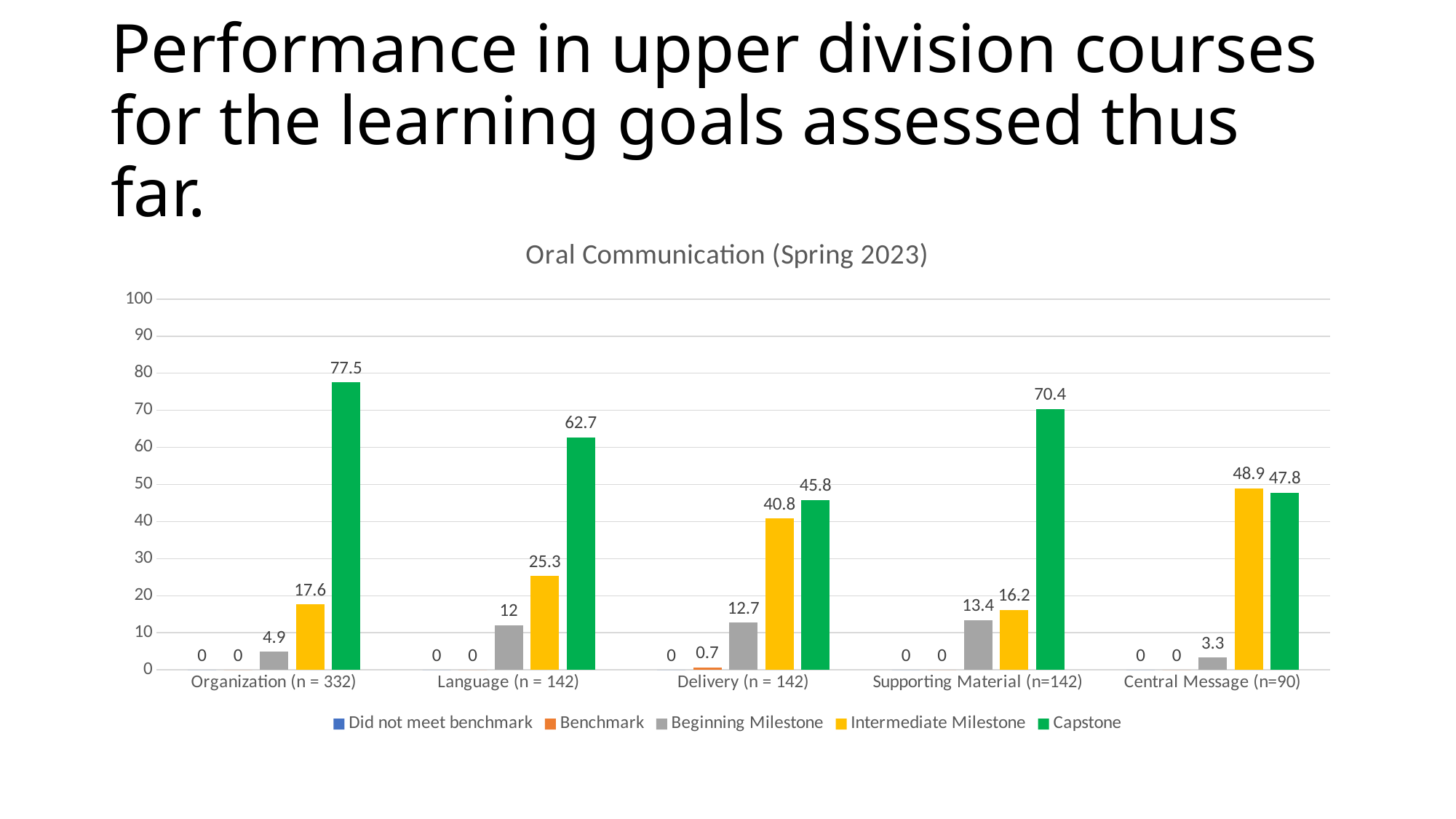
Which category has the lowest Intermediate Milestone value? Supporting Material (n=142) What is the Intermediate Milestone value for Delivery (n = 142)? 40.8 How many series does the legend list? 5 What is the title of the chart? Oral Communication (Spring 2023) How many categories are shown on the x axis? 5 What kind of chart is this? Bar chart What is the Benchmark value for Delivery (n = 142)? 0.7 Which category has the highest Capstone value? Organization (n = 332) Which is larger for Central Message (n=90): Intermediate Milestone or Capstone? Intermediate Milestone What is the difference between the Capstone values for Language (n = 142) and Supporting Material (n=142)? 7.7 What is the Beginning Milestone value for Supporting Material (n=142)? 13.4 What is the Capstone value for Organization (n = 332)? 77.5